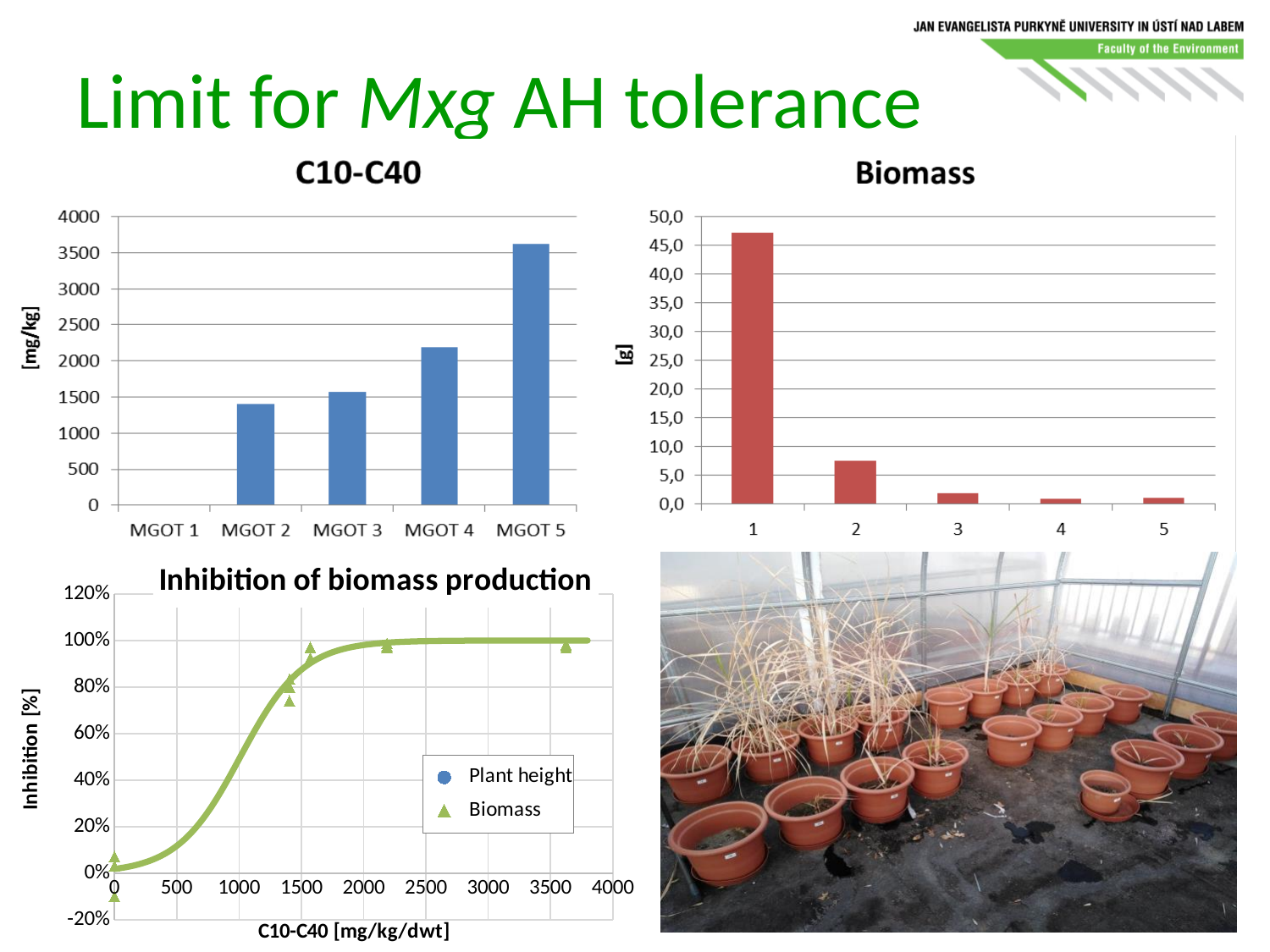
In the Biomass chart, is the value for category 1 greater or less than 45,0? greater In the C10-C40 chart, is the value for MGOT 5 greater or less than 3500? greater In the C10-C40 chart, which category has the lowest value? MGOT 1 In the C10-C40 chart, is the value for MGOT 4 greater or less than 2000? greater In the Biomass chart, which category has the highest value? 1 In the Biomass chart, which is larger, the value for category 2 or the value for category 3? category 2 In the C10-C40 chart, do the values rise or fall from MGOT 1 to MGOT 5? rise In the C10-C40 chart, which category has the highest value? MGOT 5 In the Inhibition of biomass production chart, how many series does the legend list? 2 In the C10-C40 chart, how many categories are shown on the x axis? 5